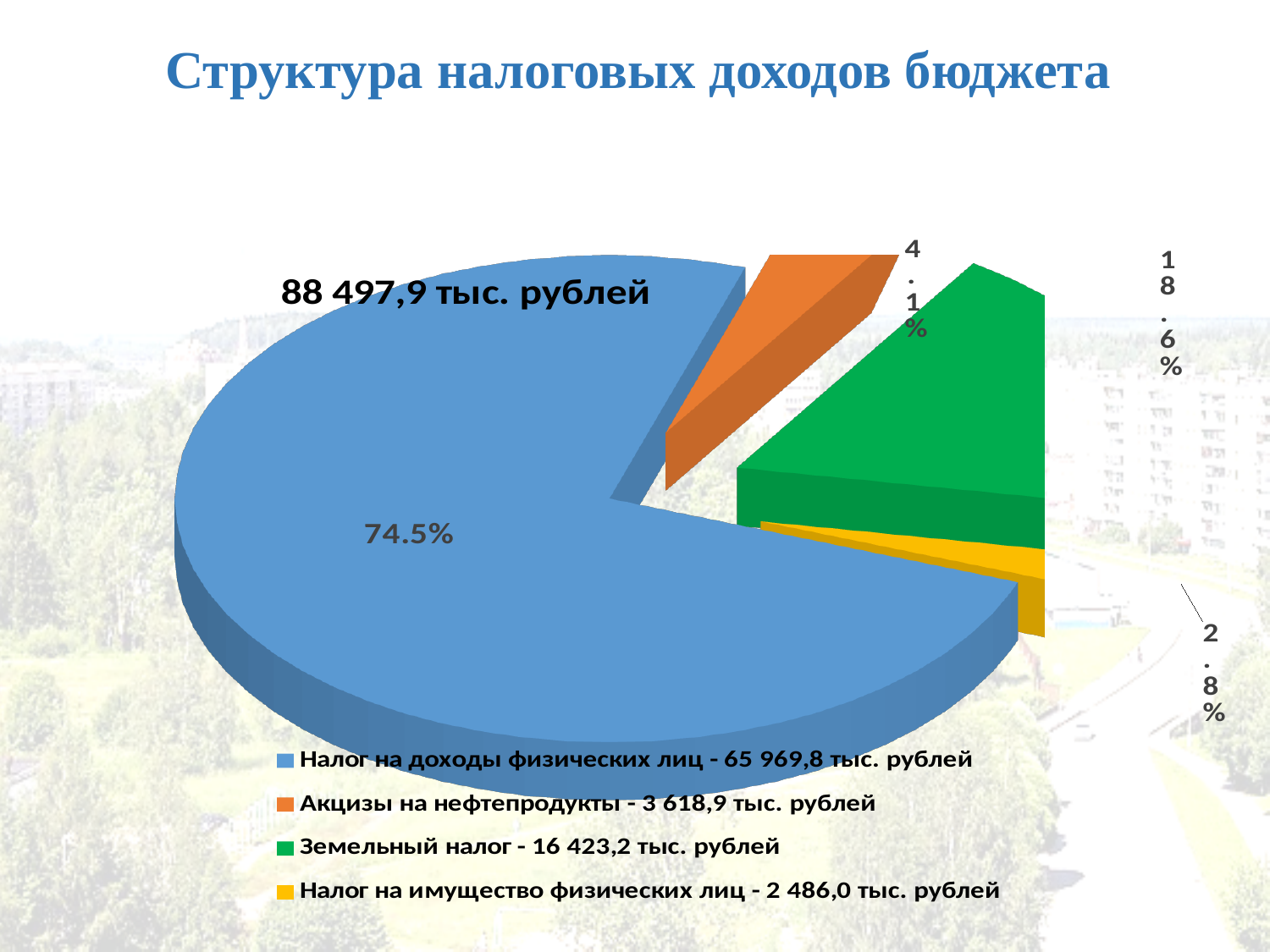
How many slices does the pie chart have? 4 What share of the pie does Акцизы на нефтепродукты take? 4.1% What total amount is printed on the chart? 88 497,9 тыс. рублей Which category has the smallest slice of the pie? Налог на имущество физических лиц What share of the pie does Земельный налог take? 18.6% What is the value for Земельный налог shown in the legend? 16 423,2 тыс. рублей Which is larger: the share for Акцизы на нефтепродукты or the share for Налог на имущество физических лиц? Акцизы на нефтепродукты Which category has the largest slice of the pie? Налог на доходы физических лиц What share of the pie does Налог на доходы физических лиц take? 74.5% How many entries does the legend list? 4 What kind of chart is shown on the slide? pie chart